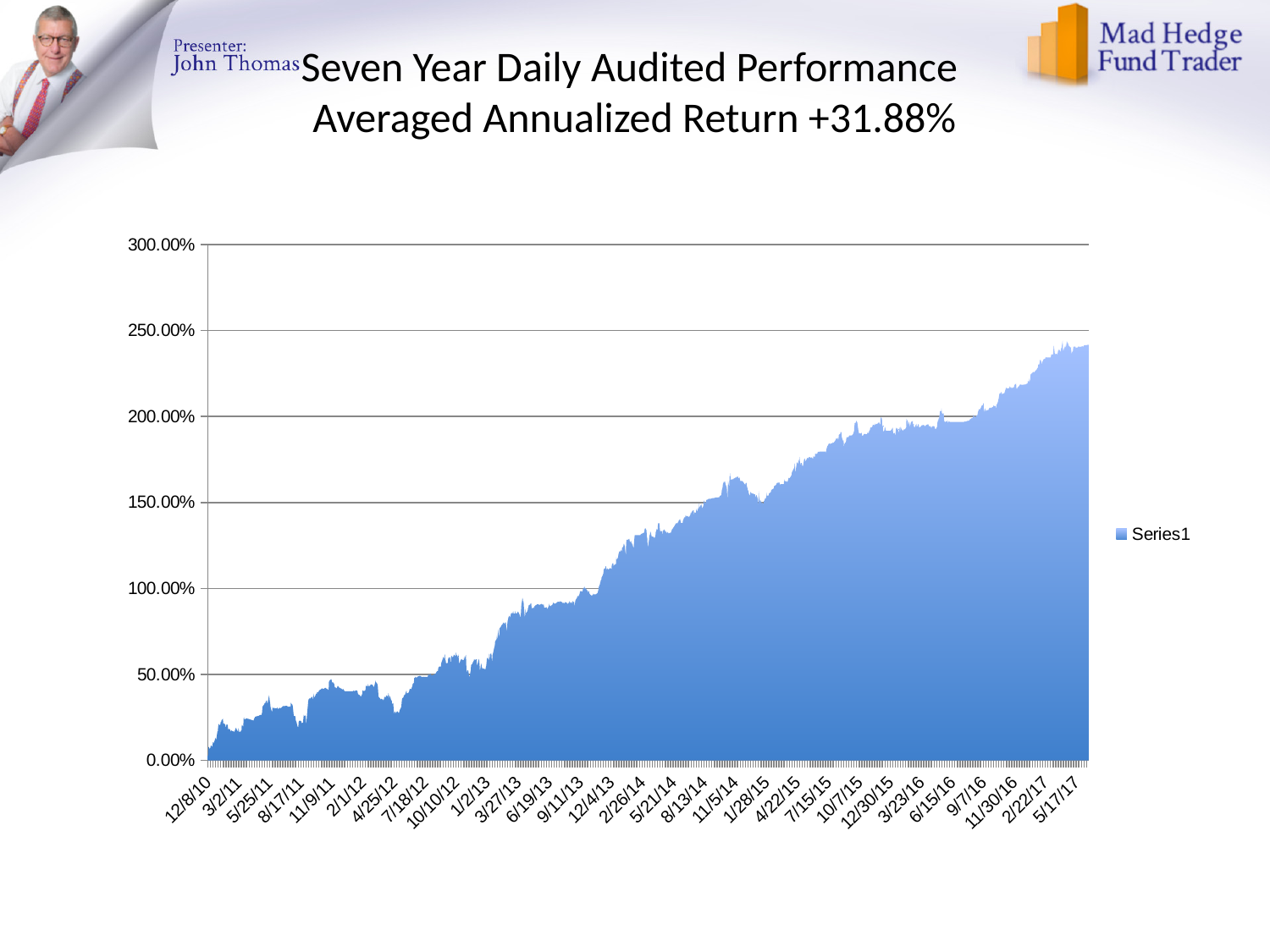
Is the value at 5/17/17 greater or less than 200.00%? greater Is the value at 2/22/17 greater or less than 200.00%? greater How many series does the legend list? 1 What is the highest value shown on the vertical axis? 300.00% What is the name of the series shown in the legend? Series1 What kind of chart is shown on the slide? area chart Is the value at 3/27/13 greater or less than 100.00%? less What is the first date label on the horizontal axis? 12/8/10 Do the values generally rise or fall from 12/8/10 to 5/17/17? rise